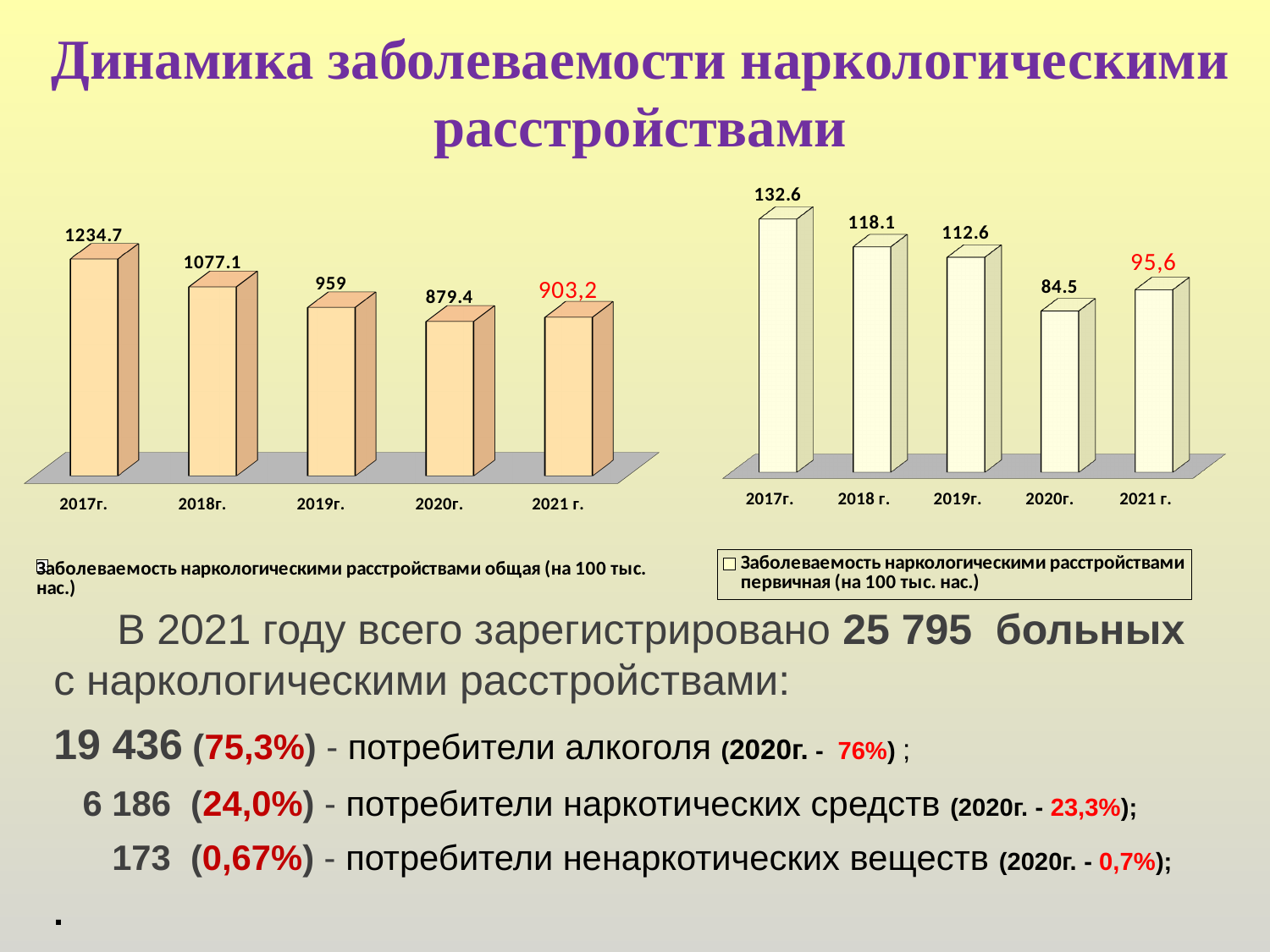
On the left chart (general incidence of narcological disorders per 100 thousand population), what is the value for 2017? 1234.7 On the right chart (primary incidence of narcological disorders per 100 thousand population), what is the value for 2020? 84.5 On the left chart (general incidence), what is the difference between the 2017 and 2018 values? 157.6 On the right chart (primary incidence), do the values rise or fall from 2017 to 2020? Fall On the left chart (general incidence), which is larger, the value for 2020 or the value for 2021? 2021 On the right chart (primary incidence), what is the value for 2018? 118.1 On the left chart (general incidence), which year has the highest value? 2017 How many years are shown on the right chart (primary incidence)? 5 On the right chart (primary incidence), which year has the lowest value? 2020 On the left chart (general incidence), what is the value for 2021? 903,2 On the right chart (primary incidence), what is the difference between the 2021 and 2020 values? 11.1 What type of chart is the left chart (general incidence)? Bar chart